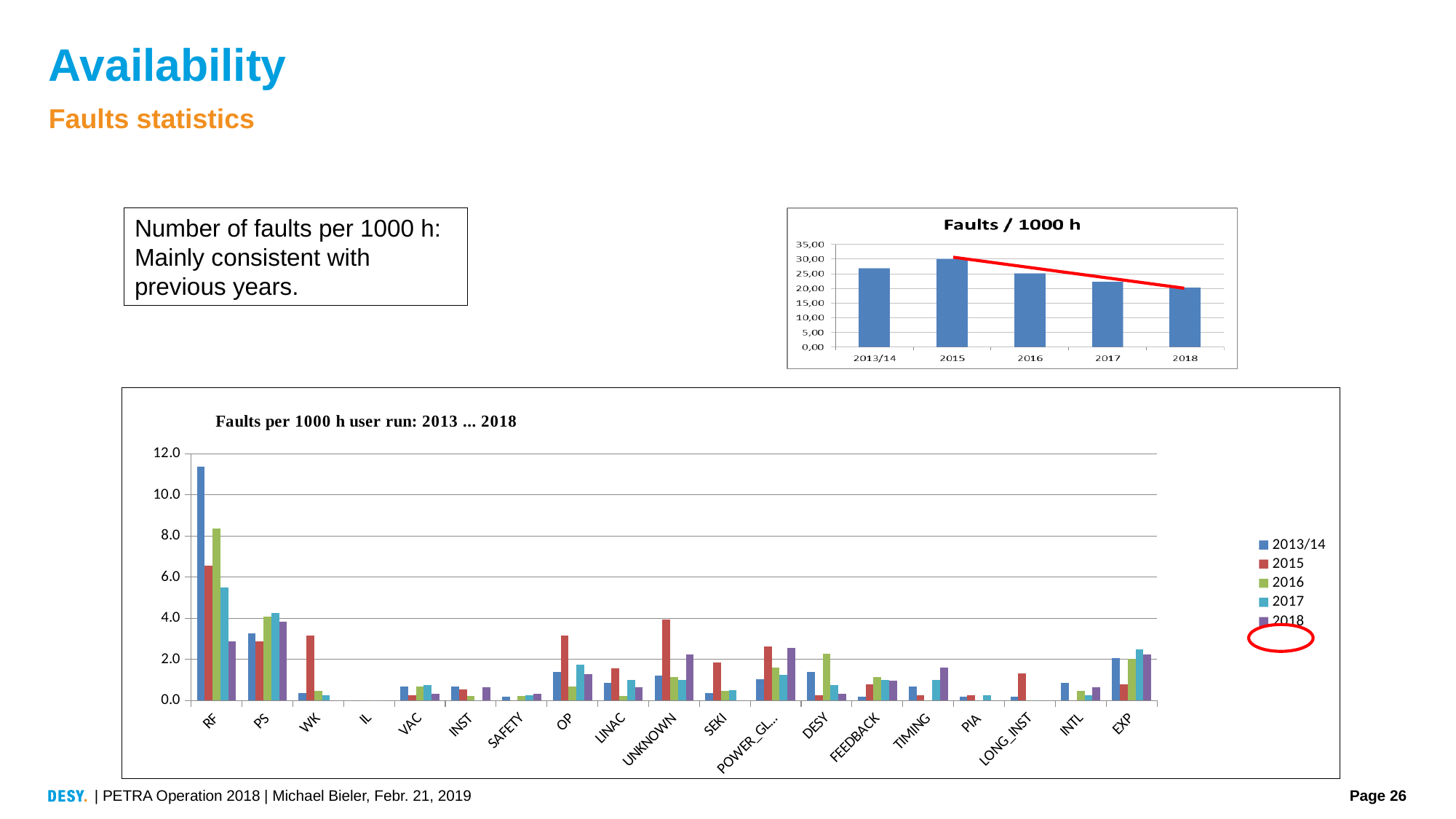
In the 'Faults / 1000 h' chart, how many years are shown on the x axis? 5 In the 'Faults / 1000 h' chart, which year has the highest value? 2015 In the 'Faults / 1000 h' chart, which year has the lowest value? 2018 In the 'Faults / 1000 h' chart, is the value for 2018 greater or less than 25,00? less In the 'Faults per 1000 h user run: 2013 ... 2018' chart, which category has the highest value for the 2013/14 series? RF In the 'Faults per 1000 h user run: 2013 ... 2018' chart, is the 2013/14 value for RF greater or less than 10.0? greater In the 'Faults per 1000 h user run: 2013 ... 2018' chart, which is larger for RF: the 2013/14 value or the 2015 value? 2013/14 In the 'Faults per 1000 h user run: 2013 ... 2018' chart, how many series does the legend list? 5 What kind of chart is the 'Faults / 1000 h' chart at the top right? bar chart In the 'Faults / 1000 h' chart, is the value for 2015 greater or less than 25,00? greater In the 'Faults per 1000 h user run: 2013 ... 2018' chart, how many categories are shown on the x axis? 19 In the 'Faults / 1000 h' chart, do the values rise or fall from 2015 to 2018? fall